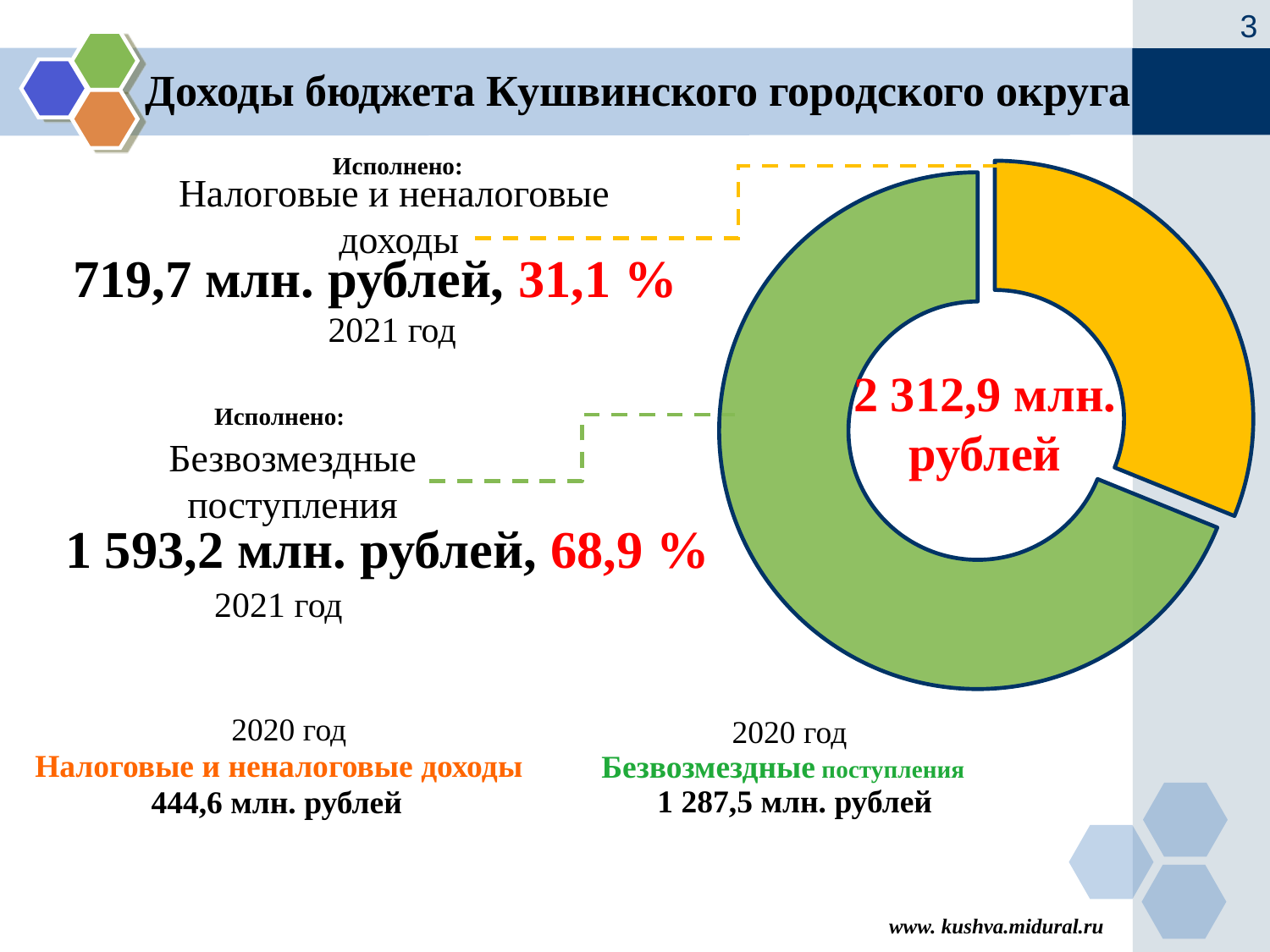
Which slice of the doughnut chart is the smallest? Налоговые и неналоговые доходы What is the 2021 value for Налоговые и неналоговые доходы? 719,7 млн. рублей What share of the doughnut chart do Налоговые и неналоговые доходы make up? 31,1 % Which is larger in 2021: Налоговые и неналоговые доходы or Безвозмездные поступления? Безвозмездные поступления What total value is shown in the centre of the doughnut chart? 2 312,9 млн. рублей What kind of chart is shown on the slide? Doughnut (pie) chart What colour is the slice for Безвозмездные поступления in the doughnut chart? Green What is the 2021 value for Безвозмездные поступления? 1 593,2 млн. рублей Which slice of the doughnut chart is the largest? Безвозмездные поступления What share of the doughnut chart do Безвозмездные поступления make up? 68,9 % What is the difference between Безвозмездные поступления and Налоговые и неналоговые доходы in 2021? 873,5 млн. рублей How many slices does the doughnut chart have? 2